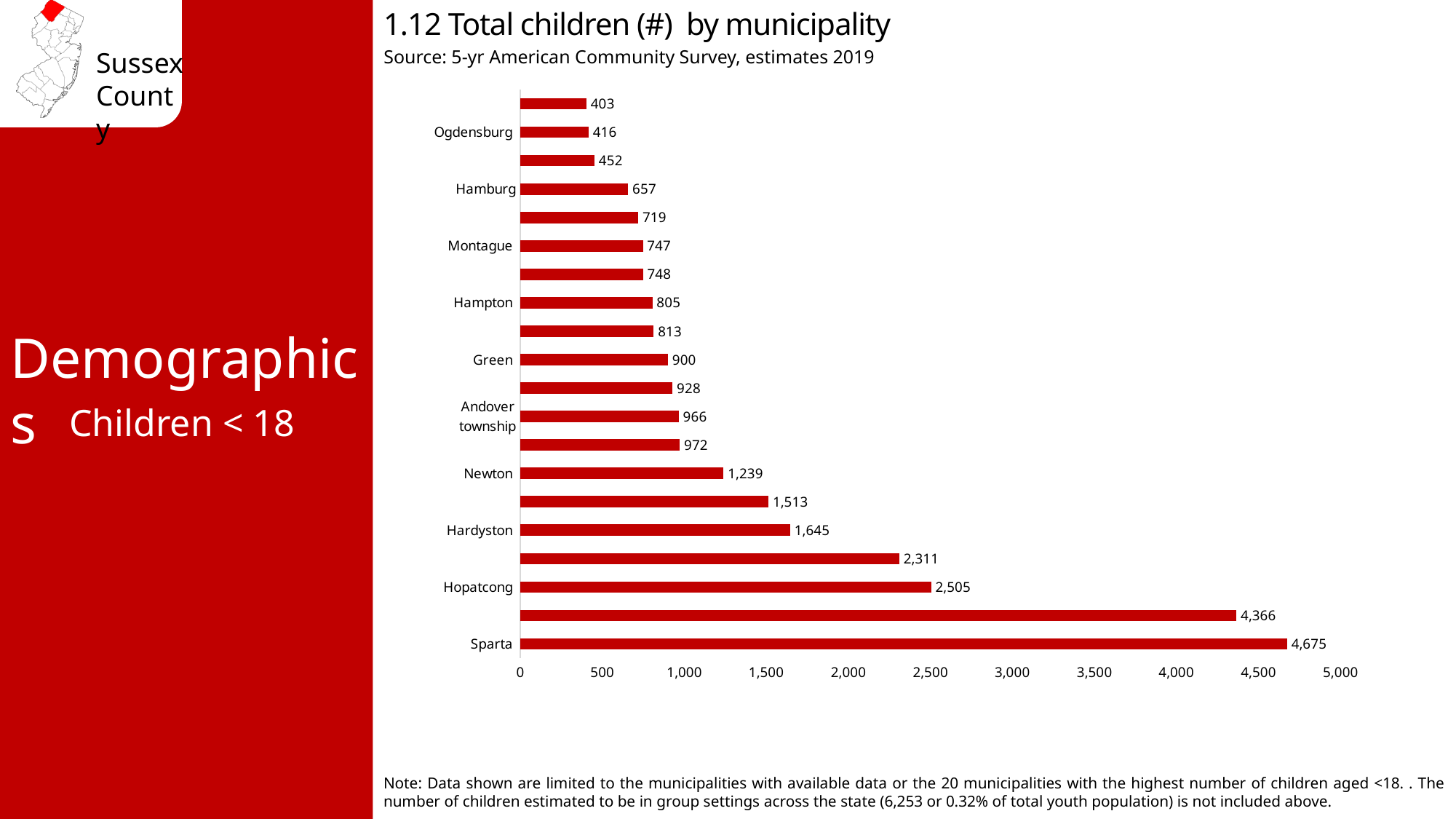
What is the difference between the values for Sparta and Hopatcong? 2,170 How many children are shown for Sparta? 4,675 What is the difference between the values for Hardyston and Newton? 406 What is the value for Hopatcong? 2,505 What type of chart is shown on the slide? bar chart Which municipality has the highest number of children? Sparta What is the source cited for the chart? 5-yr American Community Survey, estimates 2019 How many bars are plotted on the chart? 20 What is the smallest value shown on the chart? 403 Which has a larger value, Green or Montague? Green What is the value for Ogdensburg? 416 What is the value for Newton? 1,239